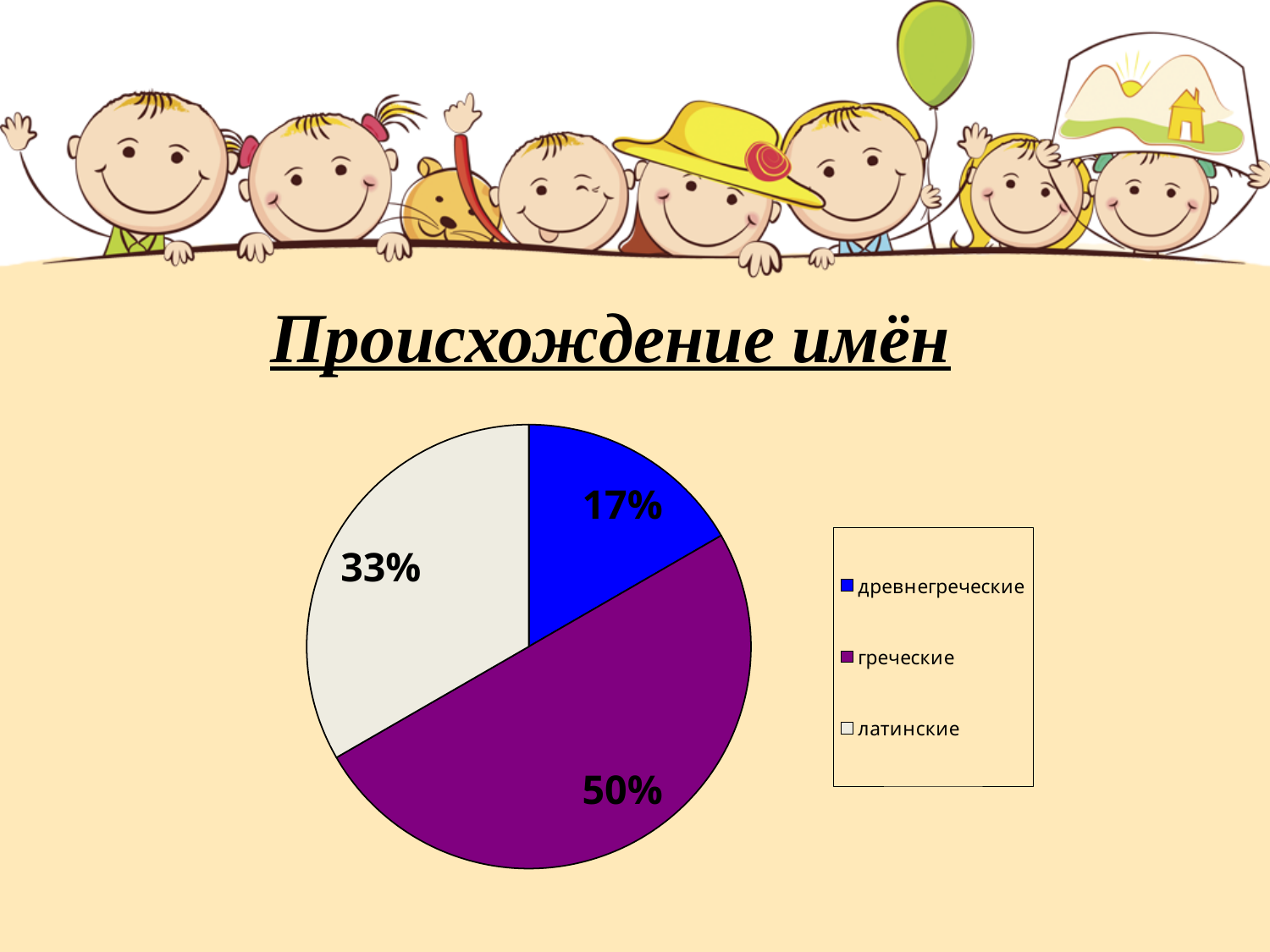
How many slices does the pie chart have? 3 What share of the pie is labelled for греческие? 50% How many entries does the legend list? 3 What share of the pie is labelled for латинские? 33% What share of the pie is labelled for древнегреческие? 17% What is the difference in percentage points between the греческие slice and the латинские slice? 17 What is the difference in percentage points between the латинские slice and the древнегреческие slice? 16 Which category has the smallest slice of the pie? древнегреческие What colour is the slice for греческие? purple Which category has the largest slice of the pie? греческие What kind of chart is shown on the slide? pie chart Which slice is larger, латинские or древнегреческие? латинские